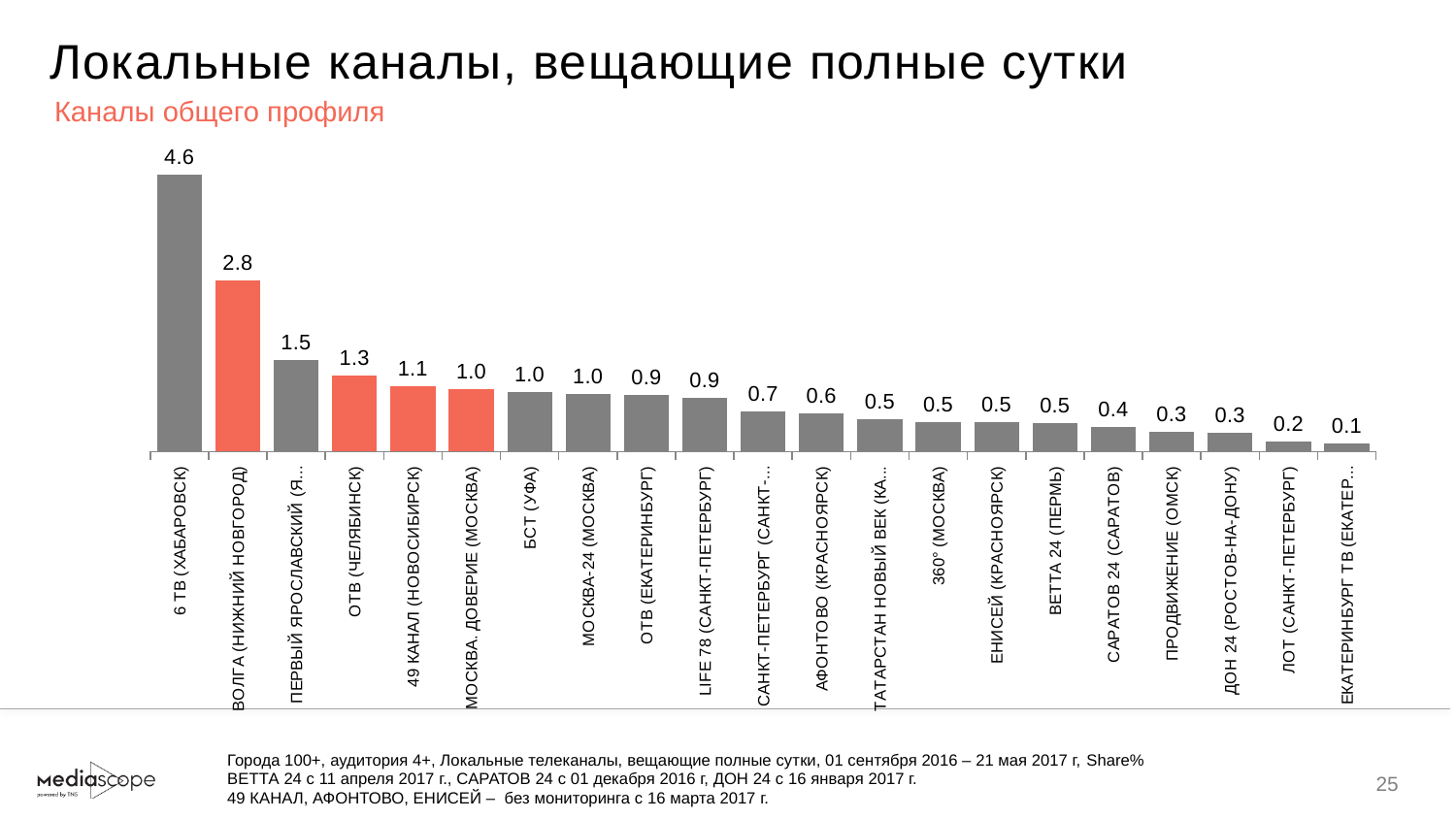
Which channel has the highest value? 6 ТВ (ХАБАРОВСК) What is the subtitle shown above the chart? Каналы общего профиля What is the difference between the values for 6 ТВ (ХАБАРОВСК) and ВОЛГА (НИЖНИЙ НОВГОРОД)? 1.8 What is the value for 6 ТВ (ХАБАРОВСК)? 4.6 Do the values rise or fall from left to right along the x axis? Fall What is the value for ВЕТТА 24 (ПЕРМЬ)? 0.5 Which channel has the lowest value? ЕКАТЕРИНБУРГ ТВ (ЕКАТЕР...) What is the value for ОТВ (ЧЕЛЯБИНСК)? 1.3 What is the value for ВОЛГА (НИЖНИЙ НОВГОРОД)? 2.8 Which is larger, the value for ОТВ (ЧЕЛЯБИНСК) or the value for БСТ (УФА)? ОТВ (ЧЕЛЯБИНСК) How many channels are shown in the chart? 21 What kind of chart is shown on the slide? Bar chart